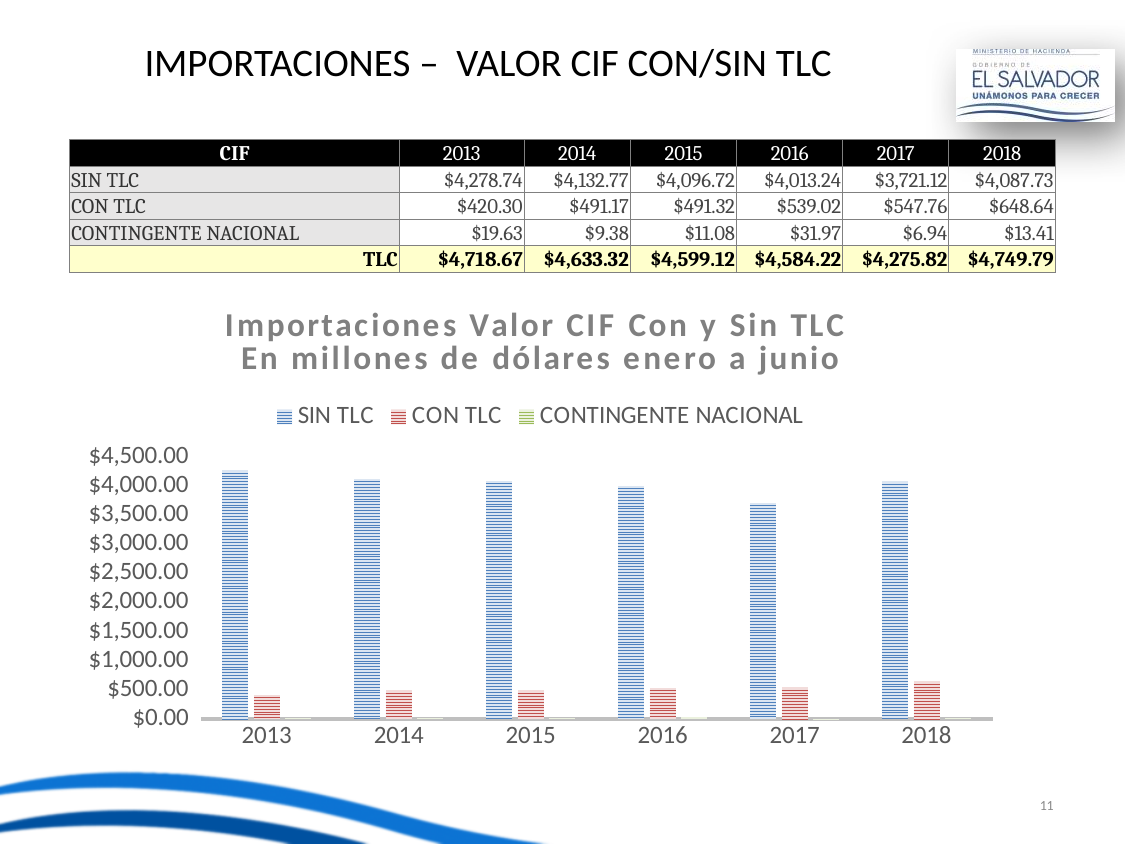
Which is larger in 2016, the SIN TLC bar or the CON TLC bar? SIN TLC According to the table, what is the CON TLC value for 2018? $648.64 What kind of chart is shown on the slide? bar chart Is the CON TLC value for 2018 greater or less than $500.00? greater Is the SIN TLC value for 2017 greater or less than $4,000.00? less How many series does the chart legend list? 3 According to the table, what is the SIN TLC value for 2013? $4,278.74 How many years are shown along the x axis of the chart? 6 According to the table, what is the difference between the CON TLC values for 2018 and 2013? $228.34 What is the title of the chart? Importaciones Valor CIF Con y Sin TLC En millones de dólares enero a junio Which year has the lowest SIN TLC bar in the chart? 2017 Which year has the highest SIN TLC bar in the chart? 2013